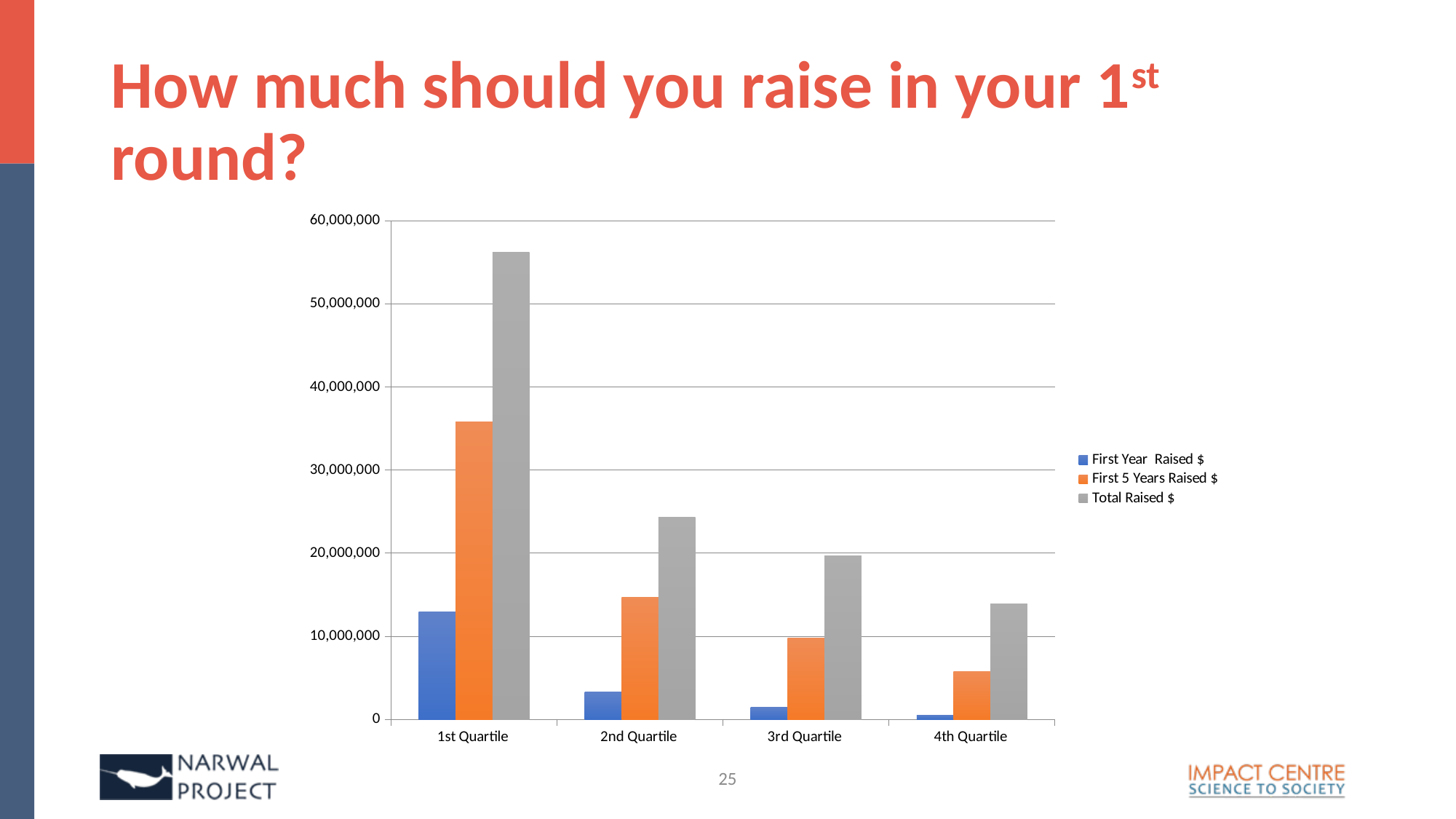
How many quartile categories are shown on the x axis? 4 Which is larger for the 2nd Quartile: First 5 Years Raised $ or Total Raised $? Total Raised $ Which quartile has the lowest First Year Raised $? 4th Quartile How many series does the legend list? 3 Which colour represents the First 5 Years Raised $ series? orange Is the First 5 Years Raised $ value for the 1st Quartile greater or less than 30,000,000? greater What kind of chart is shown on the slide? bar chart Which quartile has the highest Total Raised $? 1st Quartile Is the Total Raised $ value for the 1st Quartile greater or less than 50,000,000? greater Is the First Year Raised $ value for the 2nd Quartile greater or less than 10,000,000? less Do the Total Raised $ values rise or fall from the 1st Quartile to the 4th Quartile? fall